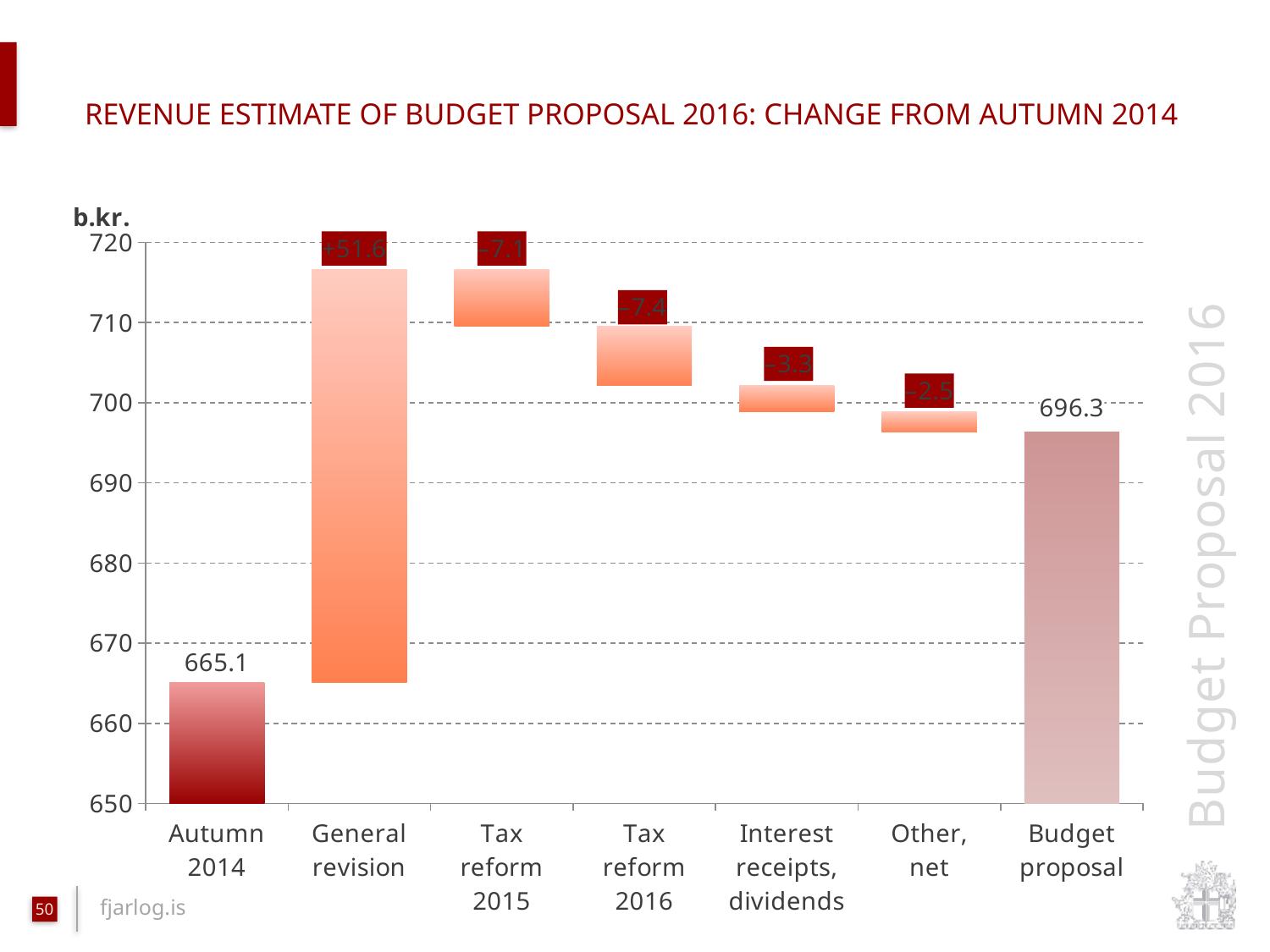
What is the value shown for the Budget proposal bar? 696.3 How many categories are shown on the x axis? 7 What is the difference between the Budget proposal value and the Autumn 2014 value? 31.2 Which category shows the largest decrease? Tax reform 2016 What change is shown for Tax reform 2016? -7.4 Is the value for the Budget proposal greater or less than 700? less Which category shows the largest positive change? General revision What change is shown for Other, net? -2.5 What change is shown for Interest receipts, dividends? -3.3 What change is shown for General revision? +51.6 What is the value shown for Autumn 2014? 665.1 Is the decrease for Tax reform 2015 larger or smaller in magnitude than the decrease for Other, net? larger